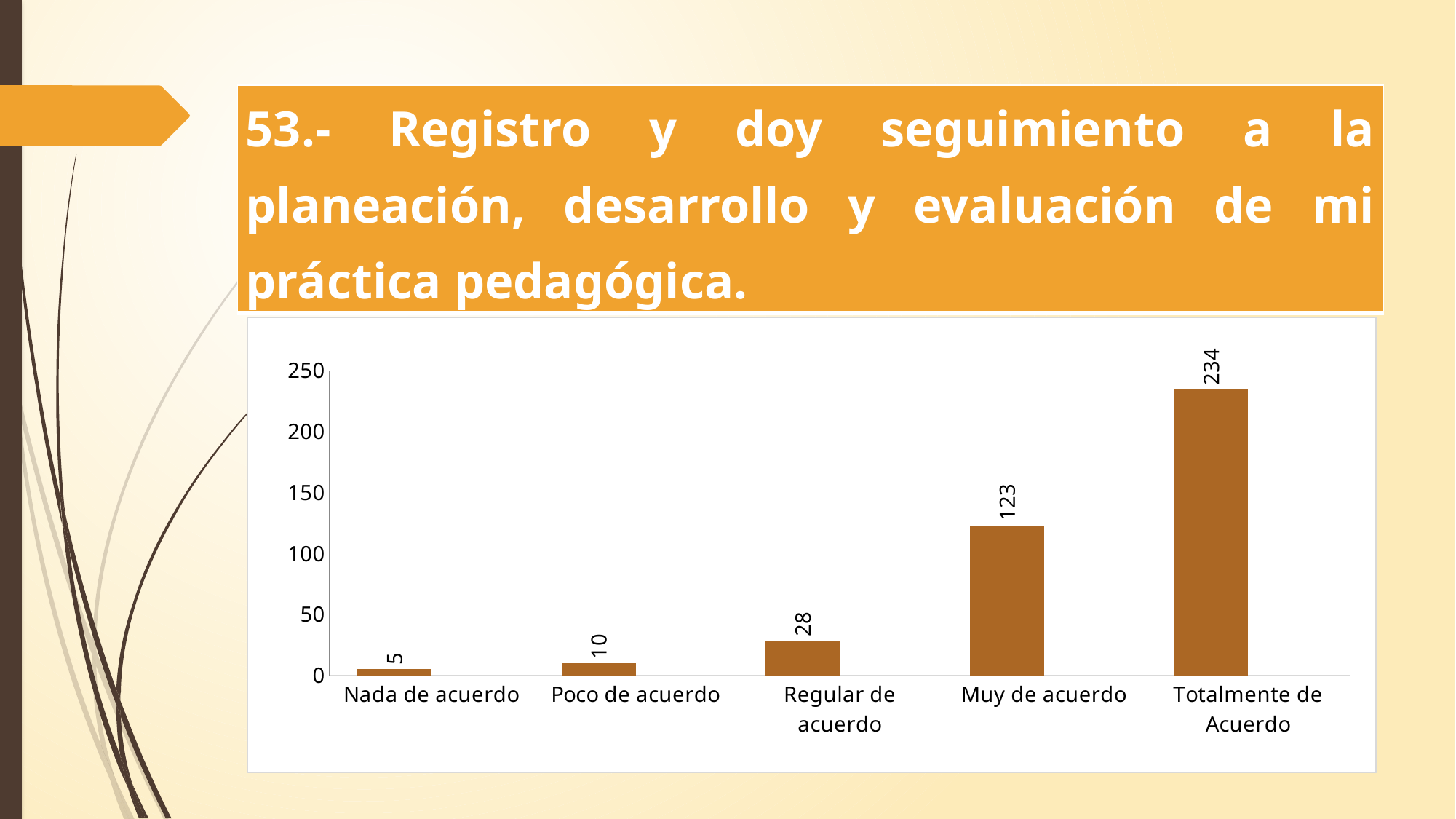
Is the value for "Muy de acuerdo" greater or less than 100? greater What is the value for "Muy de acuerdo"? 123 What is the value for "Regular de acuerdo"? 28 What is the value for "Nada de acuerdo"? 5 What is the value for "Totalmente de Acuerdo"? 234 What kind of chart is shown on the slide? bar chart How many categories are shown on the x axis? 5 Do the values rise or fall from left to right along the x axis? rise Which category has the highest value? Totalmente de Acuerdo Which is larger, the value for "Poco de acuerdo" or the value for "Regular de acuerdo"? Regular de acuerdo What is the difference between the values for "Totalmente de Acuerdo" and "Muy de acuerdo"? 111 Which category has the lowest value? Nada de acuerdo